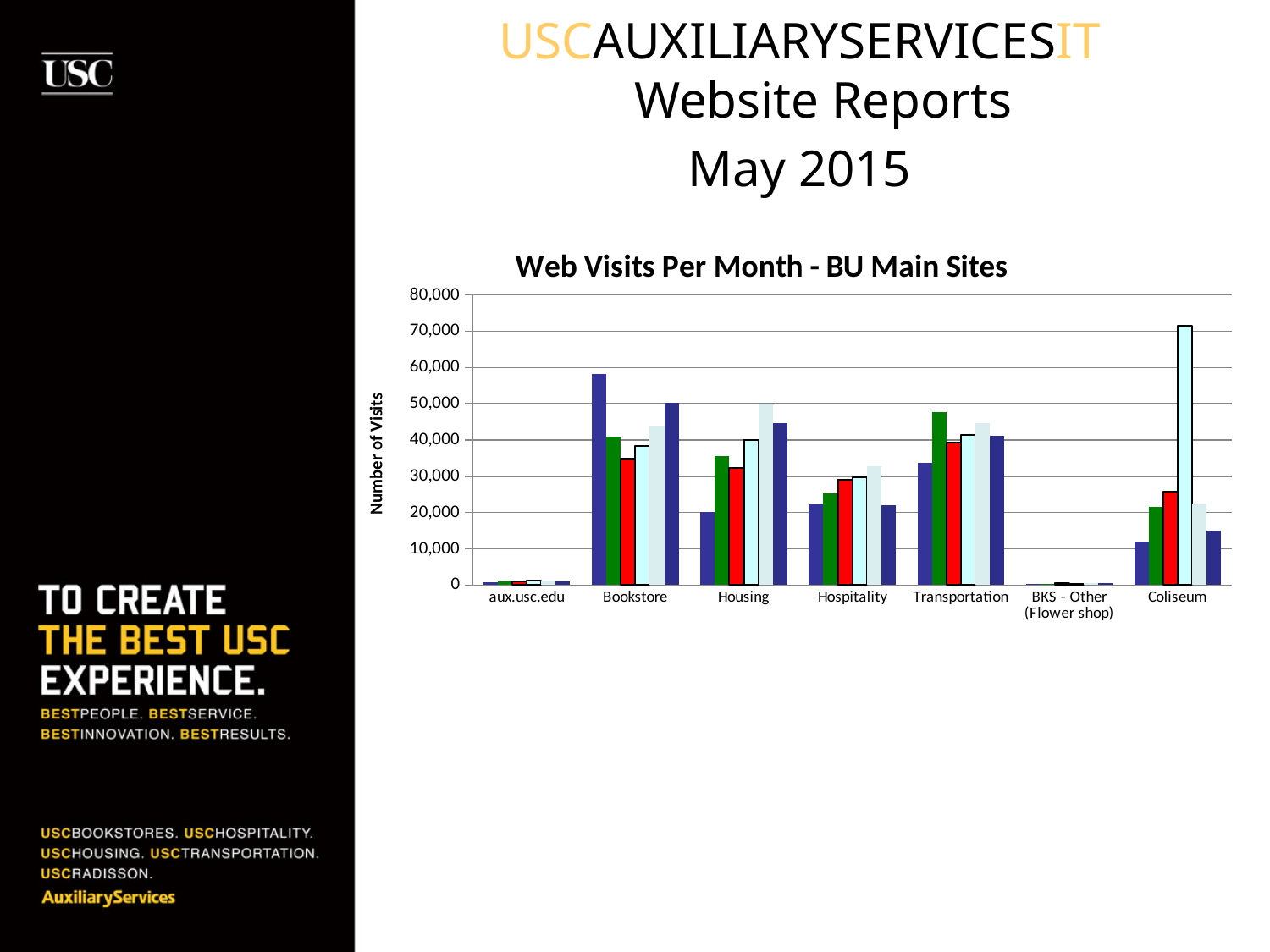
What is the highest value shown on the vertical axis of the chart? 80,000 Which category contains the tallest bar in the chart? Coliseum Is the first (leftmost) bar for Bookstore greater or less than 50,000? greater What is the title of the chart? Web Visits Per Month - BU Main Sites Are all the bars for Hospitality greater or less than 40,000? less Are all the bars for aux.usc.edu greater or less than 10,000? less Which is larger: the first (leftmost) bar for Bookstore or the first (leftmost) bar for Housing? Bookstore What kind of chart is shown on the slide? bar chart What is the label on the vertical axis of the chart? Number of Visits How many categories are shown along the x axis of the chart? 7